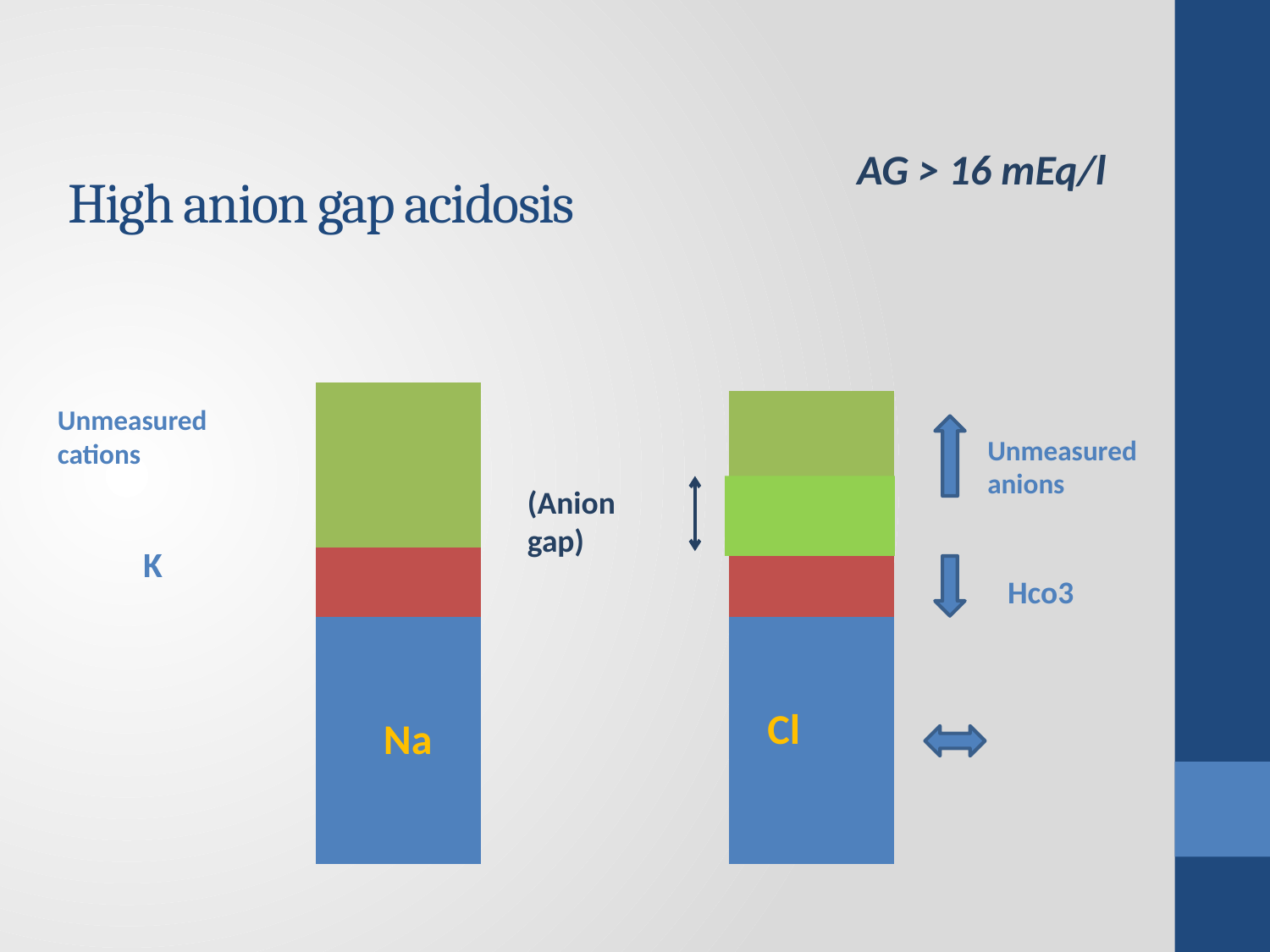
How many coloured segments make up the left bar? 3 How many coloured segments make up the right bar? 4 What label is printed on the bottom segment of the right bar? Cl In the left bar, which segment is taller, the green segment or the red segment? the green segment What kind of chart is shown on the slide? stacked bar chart How many bars are shown on the slide? 2 What label is printed on the bottom segment of the left bar? Na